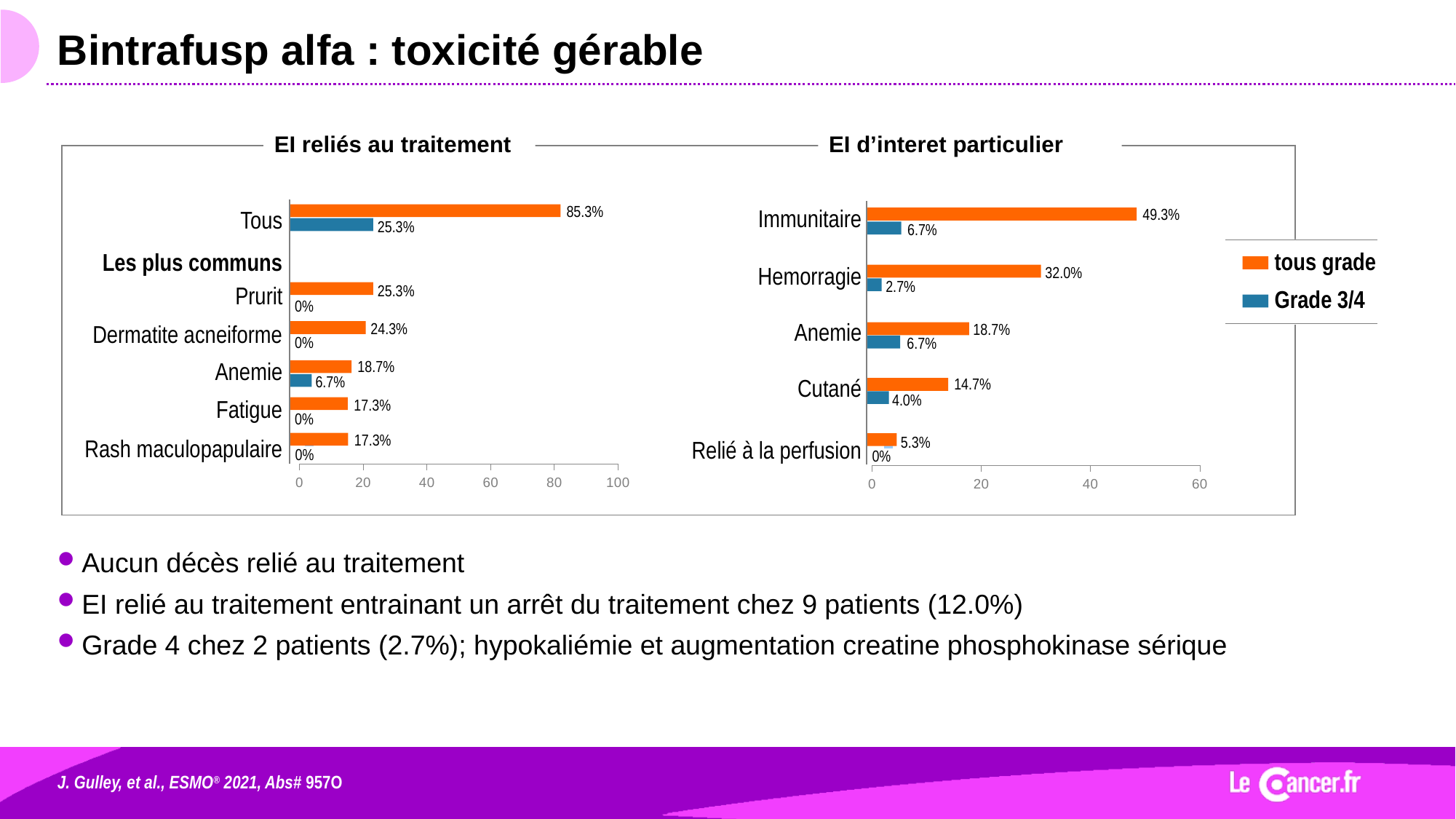
In the 'EI d'interet particulier' chart, which category has the highest 'tous grade' value? Immunitaire In the 'EI d'interet particulier' chart, what is the Grade 3/4 value for Cutané? 4.0% In the 'EI d'interet particulier' chart, which is larger: the 'tous grade' value for Hemorragie or for Anemie? Hemorragie In the 'EI reliés au traitement' chart, what is the 'tous grade' value for Dermatite acneiforme? 24.3% How many series does the legend list? 2 How many categories with bars are plotted in the 'EI d'interet particulier' chart? 5 In the 'EI reliés au traitement' chart, what is the 'tous grade' value for Tous? 85.3% In the 'EI d'interet particulier' chart, which category has the lowest 'tous grade' value? Relié à la perfusion In the 'EI d'interet particulier' chart, what is the 'tous grade' value for Hemorragie? 32.0% In the 'EI reliés au traitement' chart, what is the Grade 3/4 value for Anemie? 6.7% In the 'EI reliés au traitement' chart, what is the difference between the 'tous grade' and Grade 3/4 values for Tous? 60.0% What type of chart is the 'EI reliés au traitement' chart? Bar chart